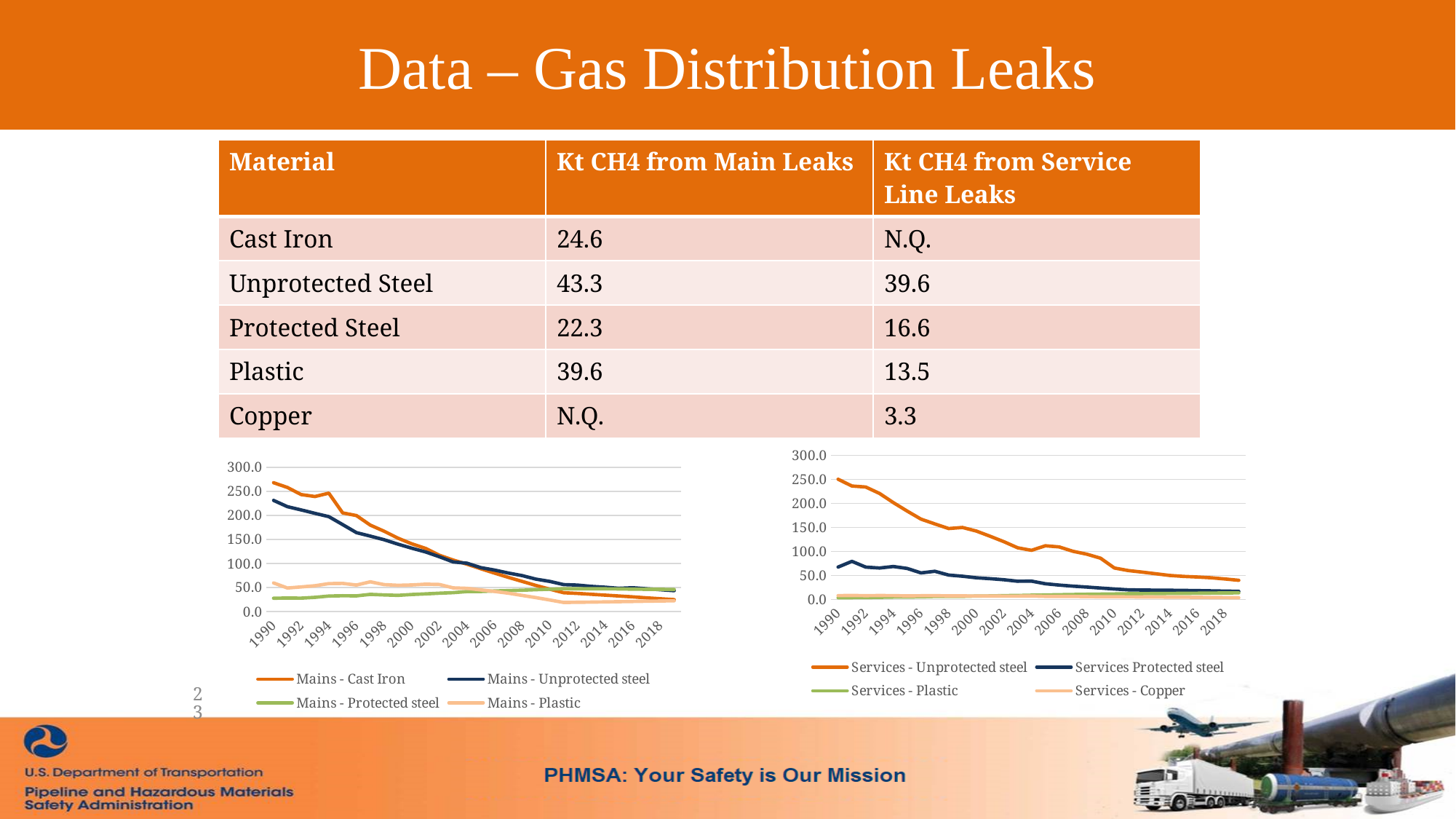
In the left chart (Mains), which series has the lowest value in 1990? Mains - Protected steel In the right chart (Services), is the value for Services Protected steel in 1990 greater or less than 100? less How many series does the legend of the left chart (Mains) list? 4 In the left chart (Mains), is the value for Mains - Cast Iron in 1990 greater or less than 250? greater What kind of chart is the left chart on the slide? line chart In the left chart (Mains), which series has the highest value in 1990? Mains - Cast Iron In the left chart (Mains), does the Mains - Cast Iron series rise or fall from 1990 to 2018? fall In the left chart (Mains), is the value for Mains - Protected steel in 1990 greater or less than 50? less How many series does the legend of the right chart (Services) list? 4 In the right chart (Services), which series has the highest value in 1990? Services - Unprotected steel In the left chart (Mains), does the Mains - Protected steel series rise or fall from 1990 to 2018? rise